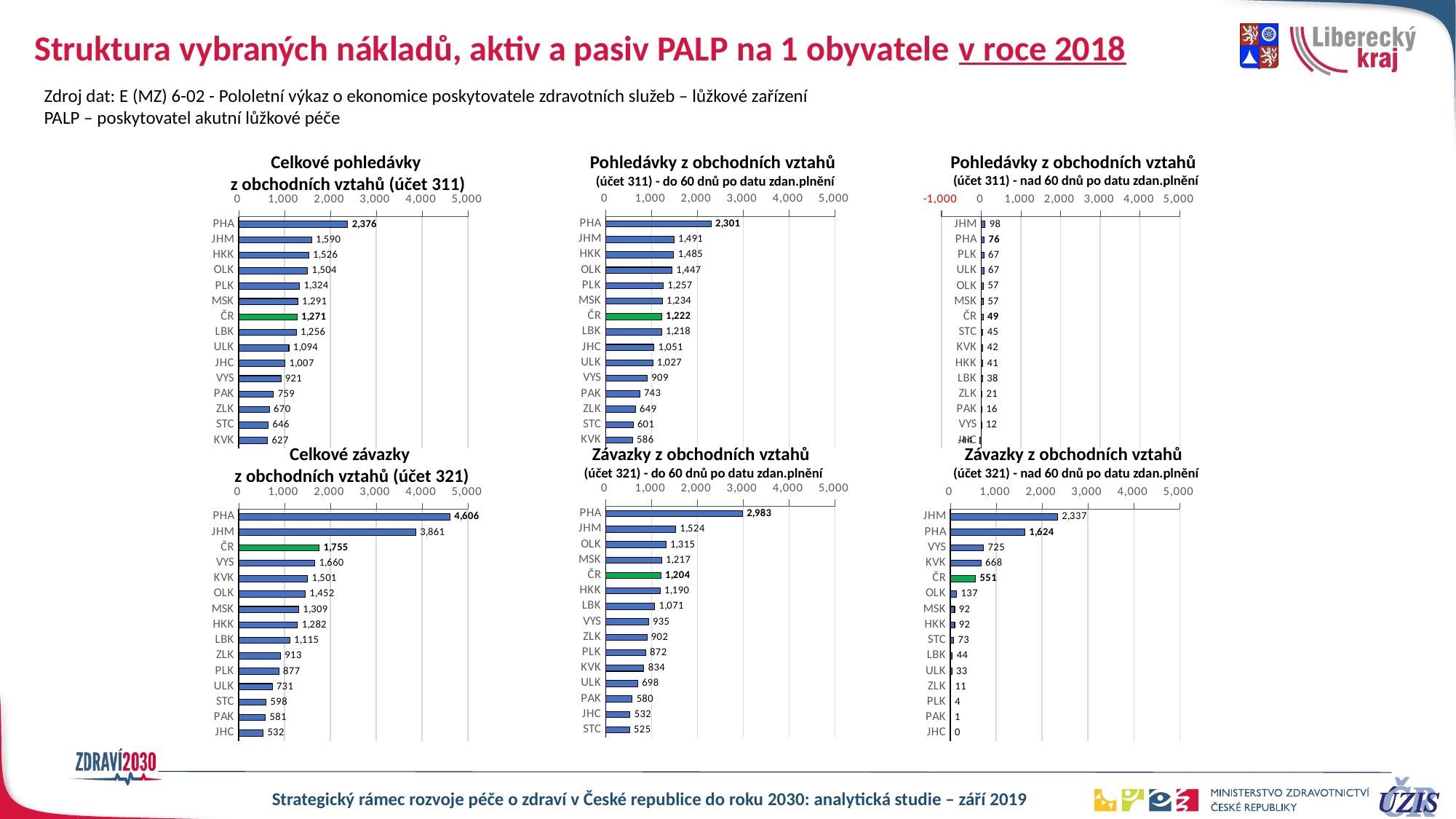
In the chart 'Závazky z obchodních vztahů (účet 321) - nad 60 dnů po datu zdan.plnění' (bottom right), what is the value for JHM? 2,337 In the chart 'Celkové pohledávky z obchodních vztahů (účet 311)' (top left), what is the difference between the values for PHA and JHM? 786 In the chart 'Závazky z obchodních vztahů (účet 321) - do 60 dnů po datu zdan.plnění' (bottom middle), what is the difference between the values for PHA and JHM? 1,459 In the chart 'Celkové závazky z obchodních vztahů (účet 321)' (bottom left), what is the value for PHA? 4,606 In the chart 'Pohledávky z obchodních vztahů (účet 311) - do 60 dnů po datu zdan.plnění' (top middle), which is larger, the value for JHC or the value for ULK? JHC In the chart 'Pohledávky z obchodních vztahů (účet 311) - nad 60 dnů po datu zdan.plnění' (top right), what is the value for VYS? 12 In the chart 'Pohledávky z obchodních vztahů (účet 311) - nad 60 dnů po datu zdan.plnění' (top right), which category has the highest value? JHM In the chart 'Celkové pohledávky z obchodních vztahů (účet 311)' (top left), what is the value for PHA? 2,376 In the chart 'Pohledávky z obchodních vztahů (účet 311) - do 60 dnů po datu zdan.plnění' (top middle), what is the value for ČR? 1,222 What type of chart is 'Závazky z obchodních vztahů (účet 321) - nad 60 dnů po datu zdan.plnění' (bottom right)? Bar chart In the chart 'Celkové pohledávky z obchodních vztahů (účet 311)' (top left), which category has the lowest value? KVK In the chart 'Celkové závazky z obchodních vztahů (účet 321)' (bottom left), how many categories are shown? 15